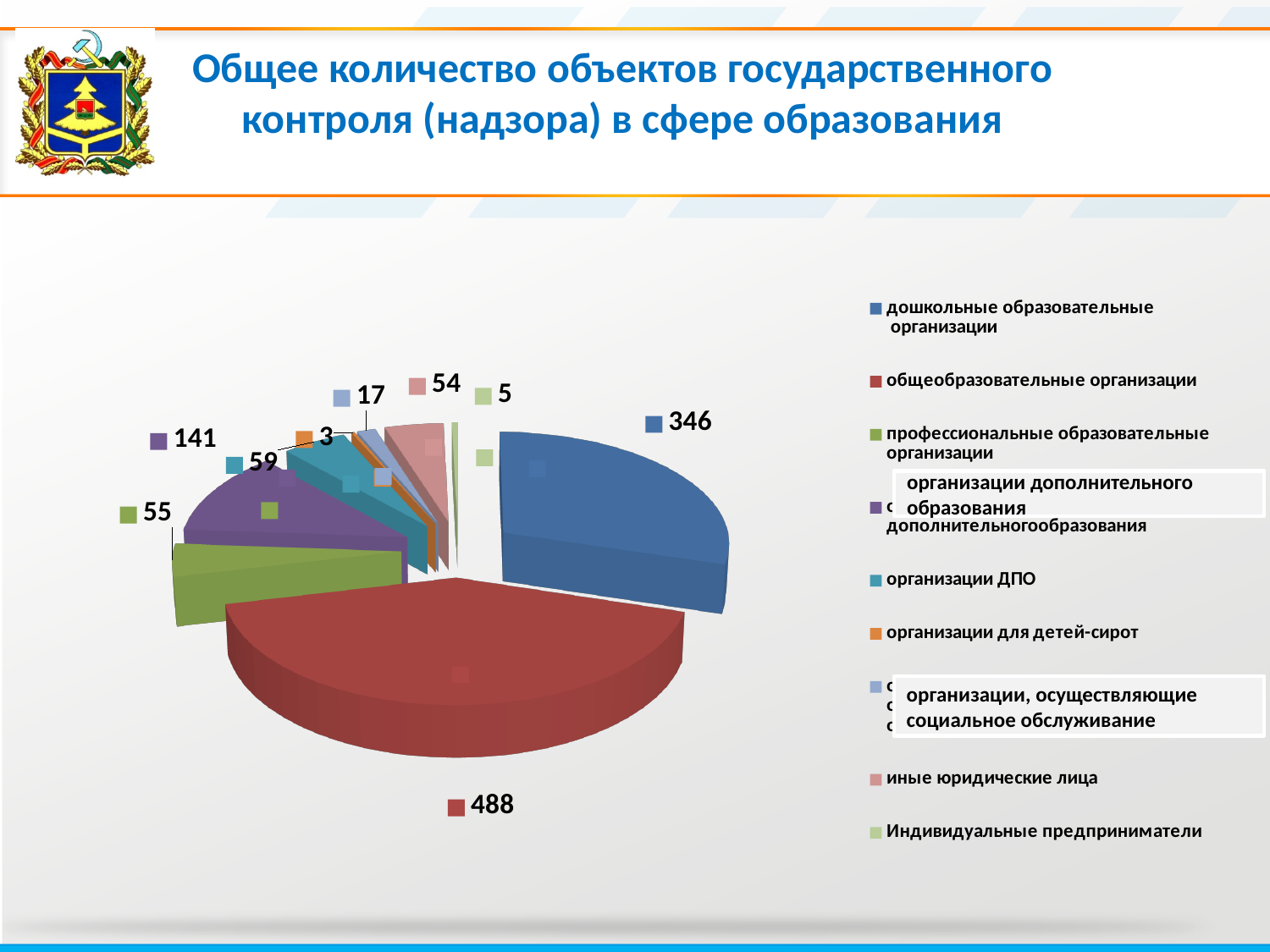
What is the title of the chart on the slide? Общее количество объектов государственного контроля (надзора) в сфере образования What is the difference between the values for общеобразовательные организации and дошкольные образовательные организации? 142 Which is larger: the value for профессиональные образовательные организации or the value for организации ДПО? организации ДПО How many categories does the legend list? 9 What is the value for организации дополнительного образования? 141 What is the value for организации ДПО? 59 What type of chart is shown on the slide? pie chart What is the value for общеобразовательные организации? 488 What is the value for дошкольные образовательные организации? 346 Which category has the largest slice of the pie? общеобразовательные организации Which category has the smallest slice of the pie? организации для детей-сирот What is the value for иные юридические лица? 54